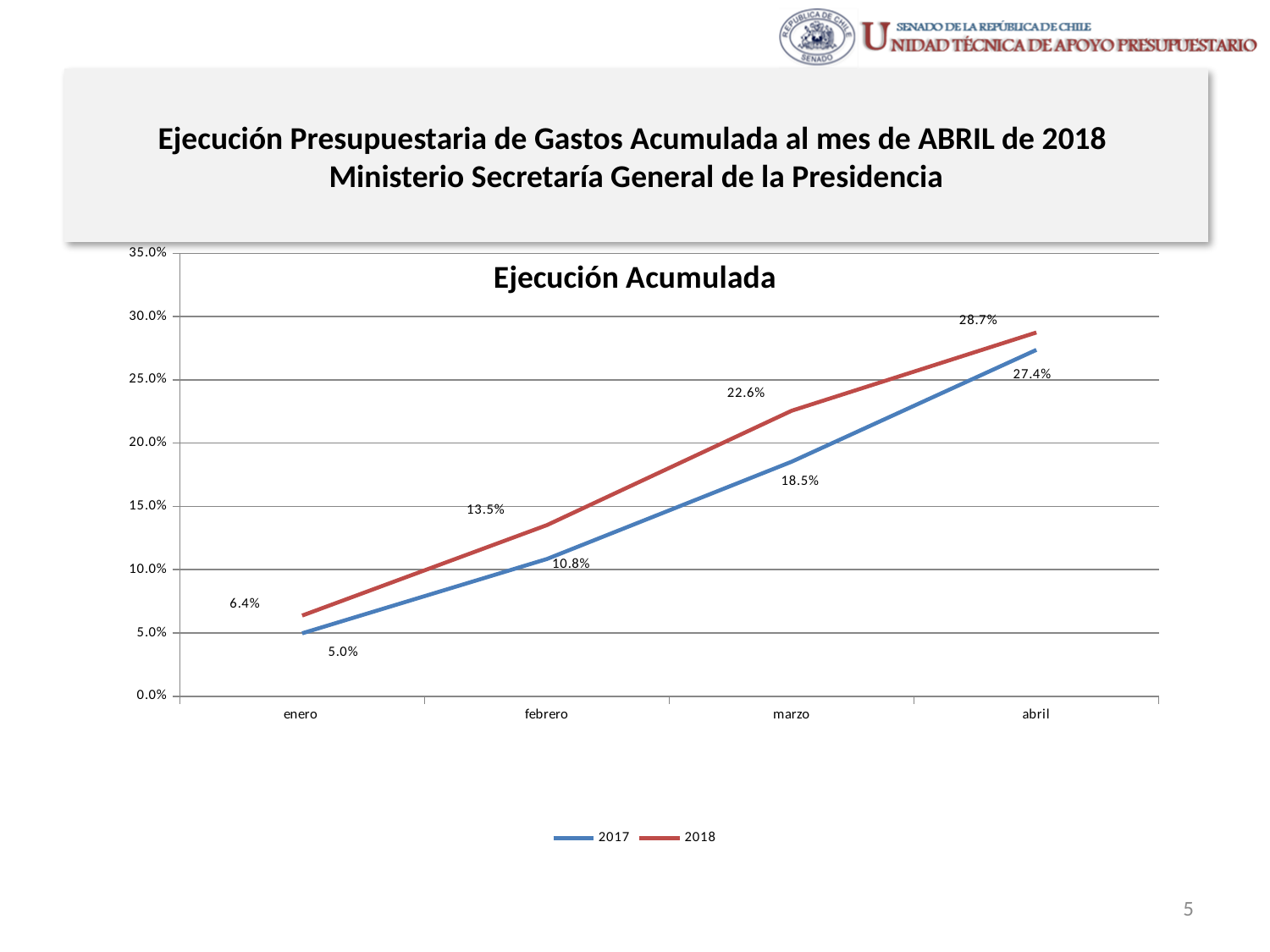
What is the value for 2018 in enero? 6.4% Which series has the larger value in febrero, 2017 or 2018? 2018 In which month is the 2018 series highest? abril Do the values of the 2017 series rise or fall from enero to abril? rise What is the value for 2018 in abril? 28.7% How many series does the legend list? 2 In which month is the 2017 series lowest? enero What kind of chart is shown? line chart What is the difference between the 2018 and 2017 values in marzo? 4.1% How many months are shown on the x axis? 4 What is the value for 2017 in febrero? 10.8% What is the value for 2017 in marzo? 18.5%